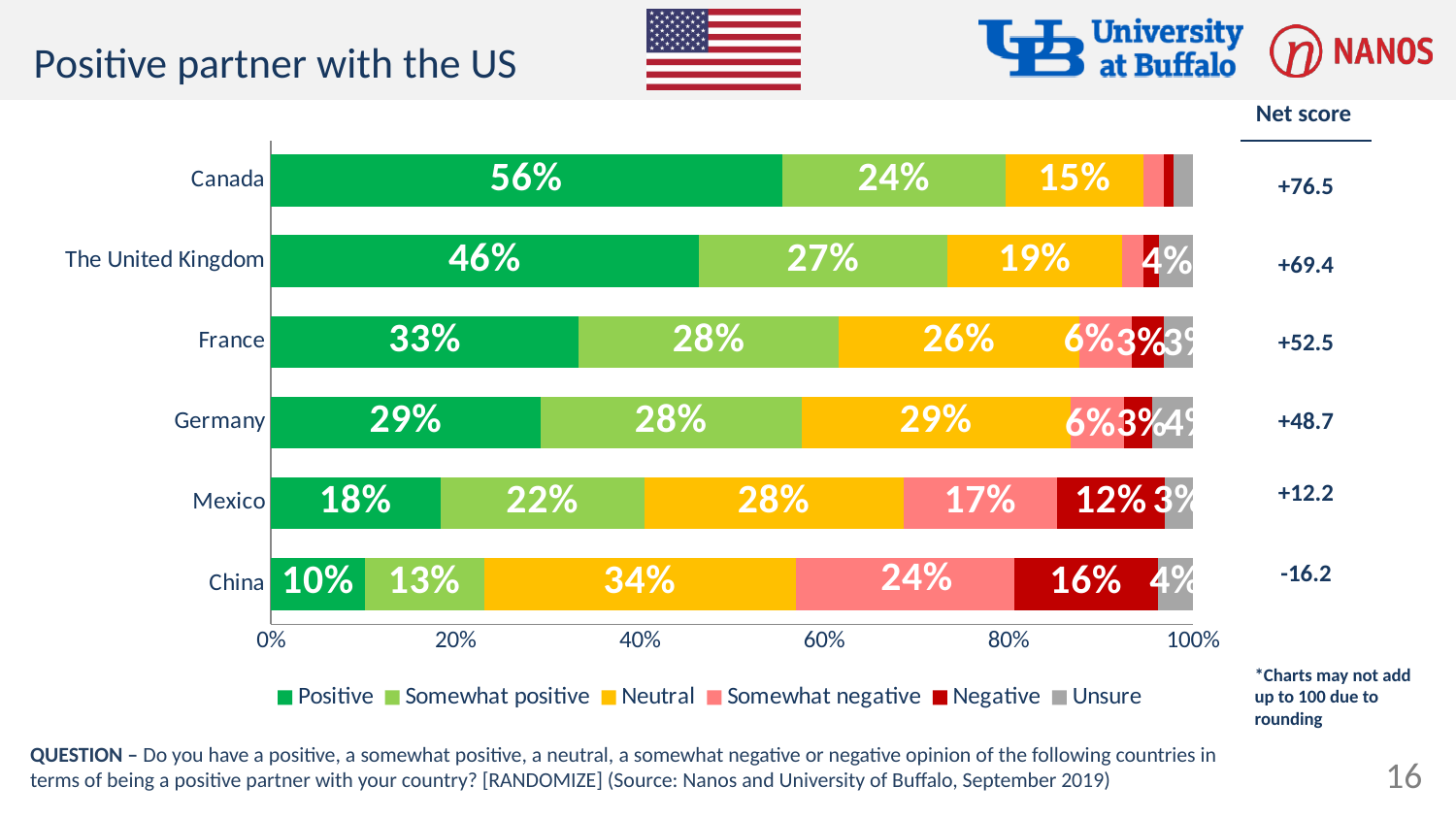
What percentage of respondents in Canada have a positive opinion of the US as a partner? 56% How many series does the legend list? 6 Which is larger: the Negative share for China or the Negative share for Mexico? China Which country has the highest Positive share? Canada What colour represents the Neutral category in the chart? Yellow What is the difference between the Positive share for Canada and the Positive share for The United Kingdom? 10% How many countries are shown in the chart? 6 What kind of chart is shown on the slide? Stacked bar chart What is the Neutral share for China? 34% What is the Somewhat negative share for Mexico? 17% What is the net score for Germany? +48.7 Which country has the lowest net score? China